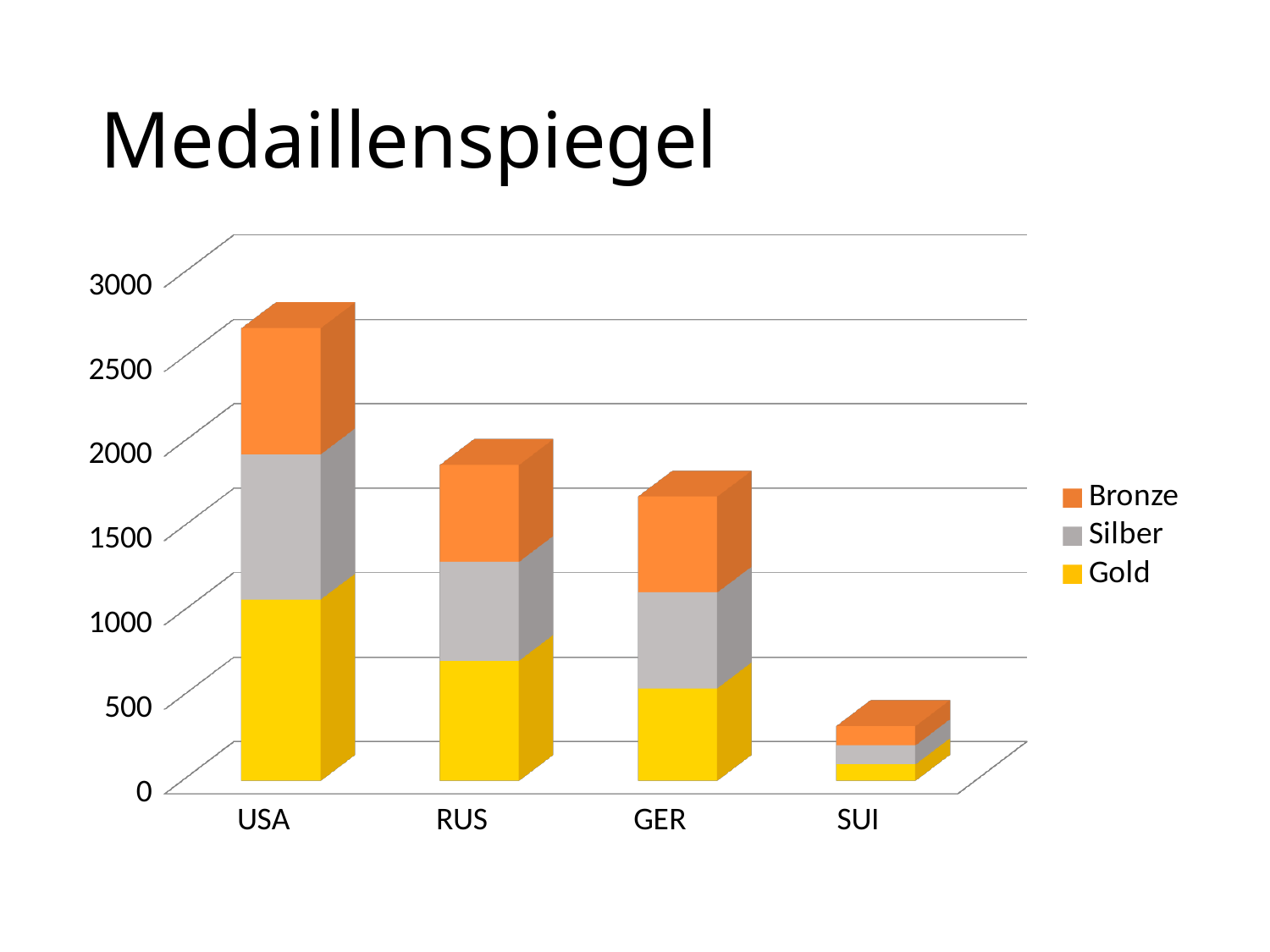
Is the total value for USA greater or less than 2000? greater What is the title of the chart? Medaillenspiegel Do the stacked bar totals rise or fall from USA to SUI along the x axis? fall How many countries are shown on the x axis of the chart? 4 Is the total value for SUI greater or less than 500? less Which colour represents the Gold series in the legend? Yellow Is the total value for GER greater or less than 2000? less Which country has the tallest stacked bar? USA How many series does the legend list? 3 Which country has a taller stacked bar, RUS or GER? RUS What type of chart is shown on the slide? Stacked bar chart Which country has the shortest stacked bar? SUI